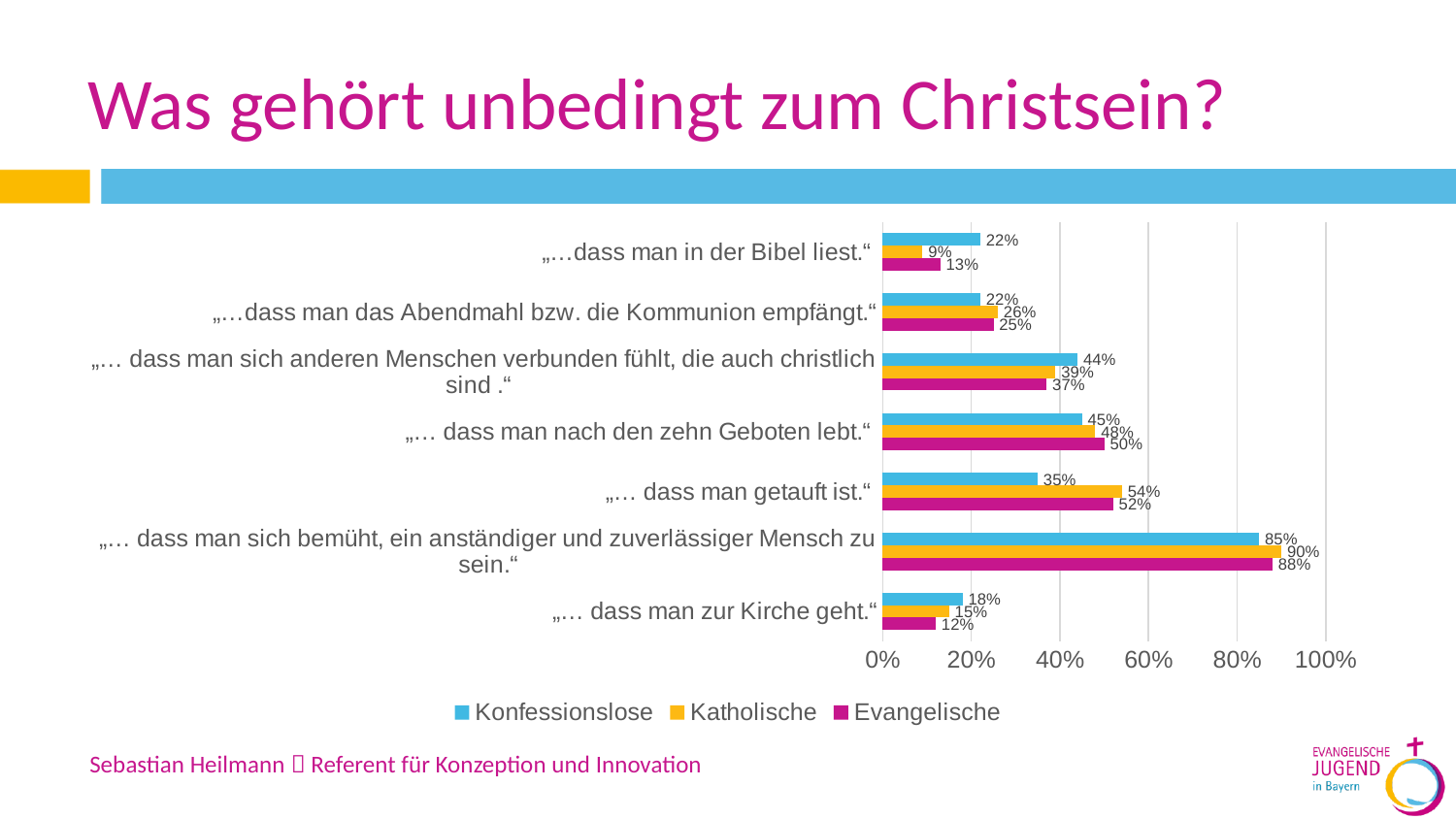
What is the difference between the Katholische and Konfessionslose values for "… dass man getauft ist."? 19% Which colour represents the Evangelische series in the chart? magenta How many series does the legend list? 3 How many categories (statements) are plotted in the chart? 7 Which statement has the lowest value for Konfessionslose? „… dass man zur Kirche geht.“ What is the value for Katholische for "… dass man getauft ist."? 54% For "…dass man in der Bibel liest.", which is larger: the value for Konfessionslose or for Katholische? Konfessionslose What is the value for Konfessionslose for "…dass man in der Bibel liest."? 22% What kind of chart is shown on the slide? bar chart Is the value for Evangelische for "… dass man sich bemüht, ein anständiger und zuverlässiger Mensch zu sein." greater or less than 80%? greater What is the value for Evangelische for "… dass man zur Kirche geht."? 12% Which statement has the highest value for Katholische? „… dass man sich bemüht, ein anständiger und zuverlässiger Mensch zu sein.“